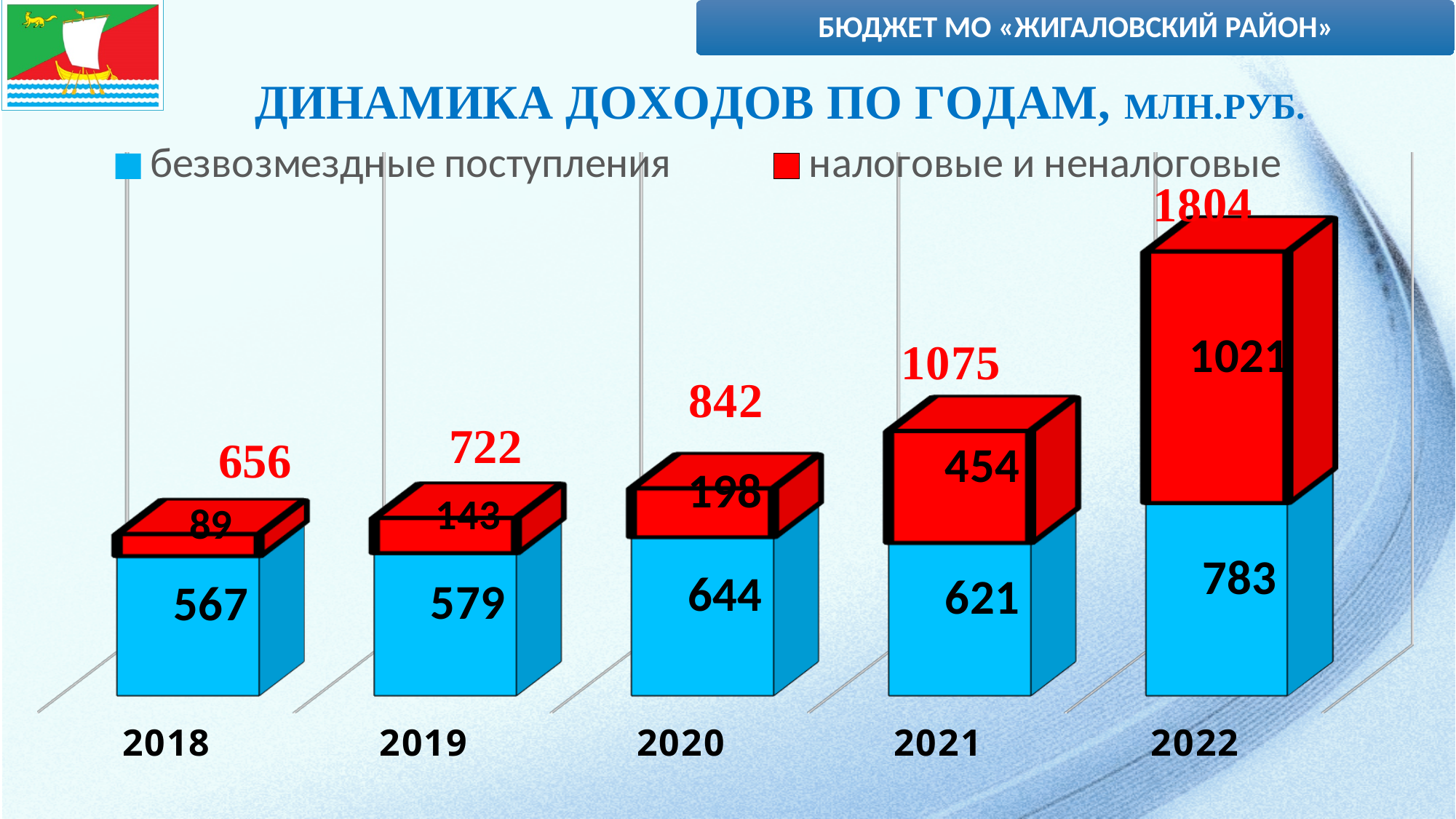
Which colour represents налоговые и неналоговые in the chart? Red How many years are shown on the x axis? 5 What is the difference between the total income in 2022 and in 2021? 729 How many series does the legend list? 2 Which year has the highest total income? 2022 Do the total income values rise or fall from 2018 to 2022? Rise Which is larger: безвозмездные поступления in 2020 or in 2021? 2020 What is the value of безвозмездные поступления for 2020? 644 What is the value of налоговые и неналоговые for 2021? 454 Which year has the lowest value for налоговые и неналоговые? 2018 What is the total income shown above the bar for 2019? 722 What kind of chart is shown on the slide? Stacked bar chart